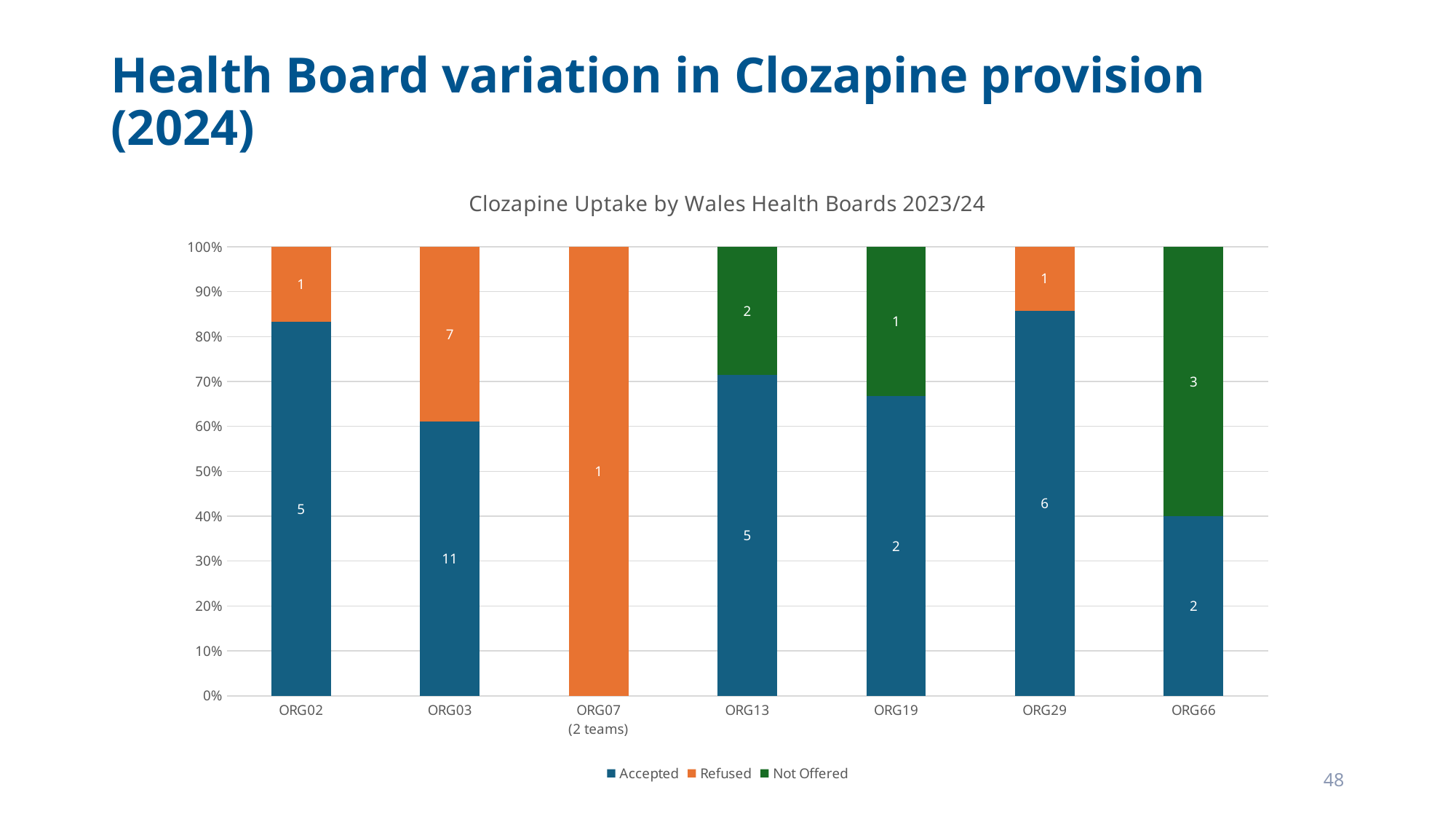
What is the Not Offered data label for ORG66? 3 Is the Accepted share of the ORG66 bar greater or less than 50%? less What is the total of the data labels in the ORG03 bar? 18 What kind of chart is shown on the slide? Stacked bar chart What is the title of the chart? Clozapine Uptake by Wales Health Boards 2023/24 How many health boards are shown on the x axis? 7 Which health board has the highest Accepted data label? ORG03 What is the Accepted data label for ORG03? 11 Which is larger, the Accepted data label for ORG29 or the Accepted data label for ORG13? ORG29 How many series does the legend list? 3 What is the difference between the Accepted and Refused data labels for ORG03? 4 What is the Refused data label for ORG02? 1